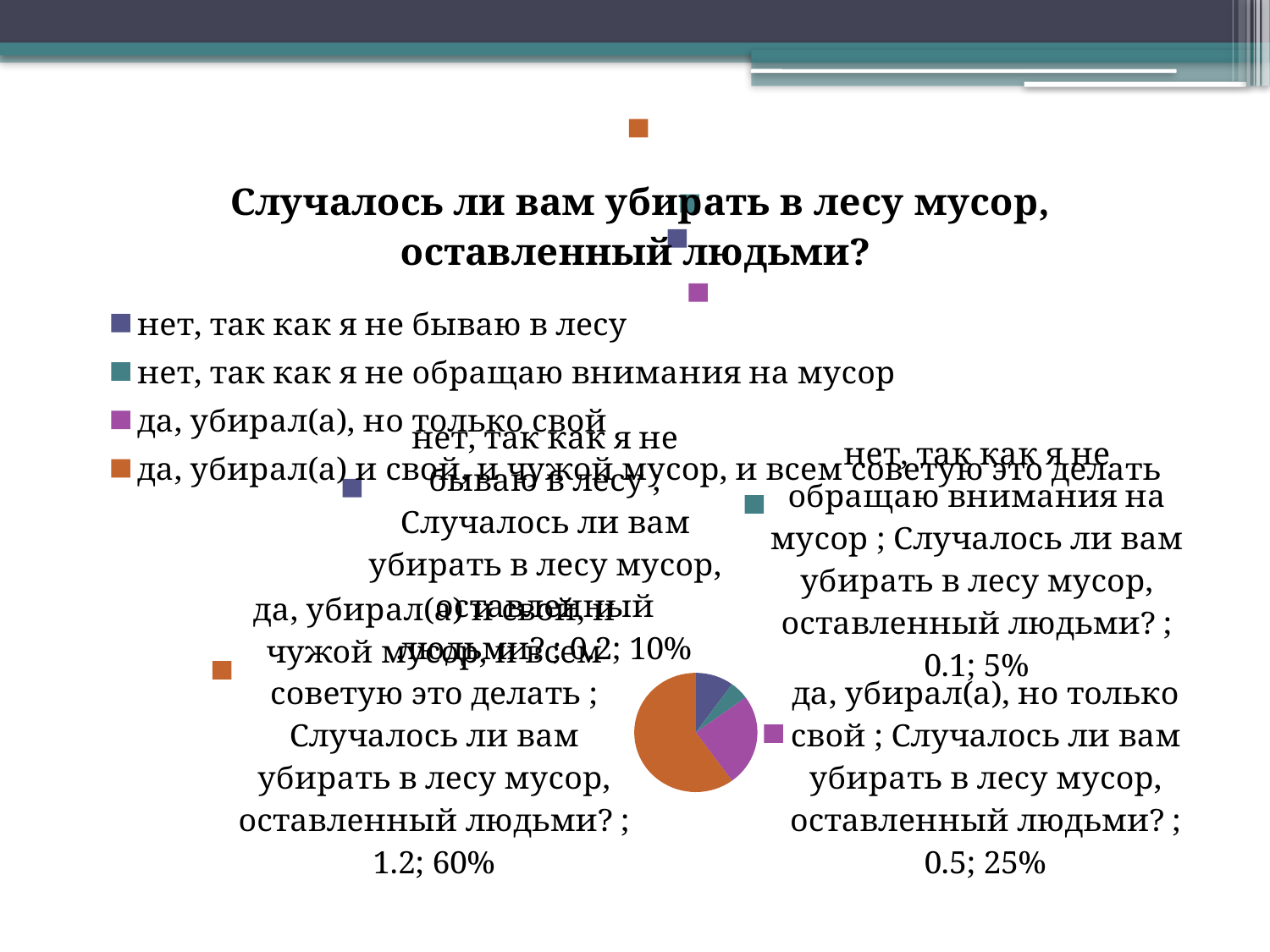
What percentage share is shown for "нет, так как я не бываю в лесу"? 10% What is the difference in percentage points between the share for "да, убирал(а), но только свой" and the share for "нет, так как я не бываю в лесу"? 15% What value is printed for "да, убирал(а), но только свой" before its percentage? 0.5 Which category has the largest slice of the pie? да, убирал(а) и свой, и чужой мусор, и всем советую это делать Which category has the smallest slice of the pie? нет, так как я не обращаю внимания на мусор How many entries does the chart legend list? 4 How many slices does the pie chart have? 4 What kind of chart is shown on the slide? pie chart What percentage share is shown for "нет, так как я не обращаю внимания на мусор"? 5% What percentage share is shown for "да, убирал(а) и свой, и чужой мусор, и всем советую это делать"? 60% What is the title of the chart? Случалось ли вам убирать в лесу мусор, оставленный людьми?